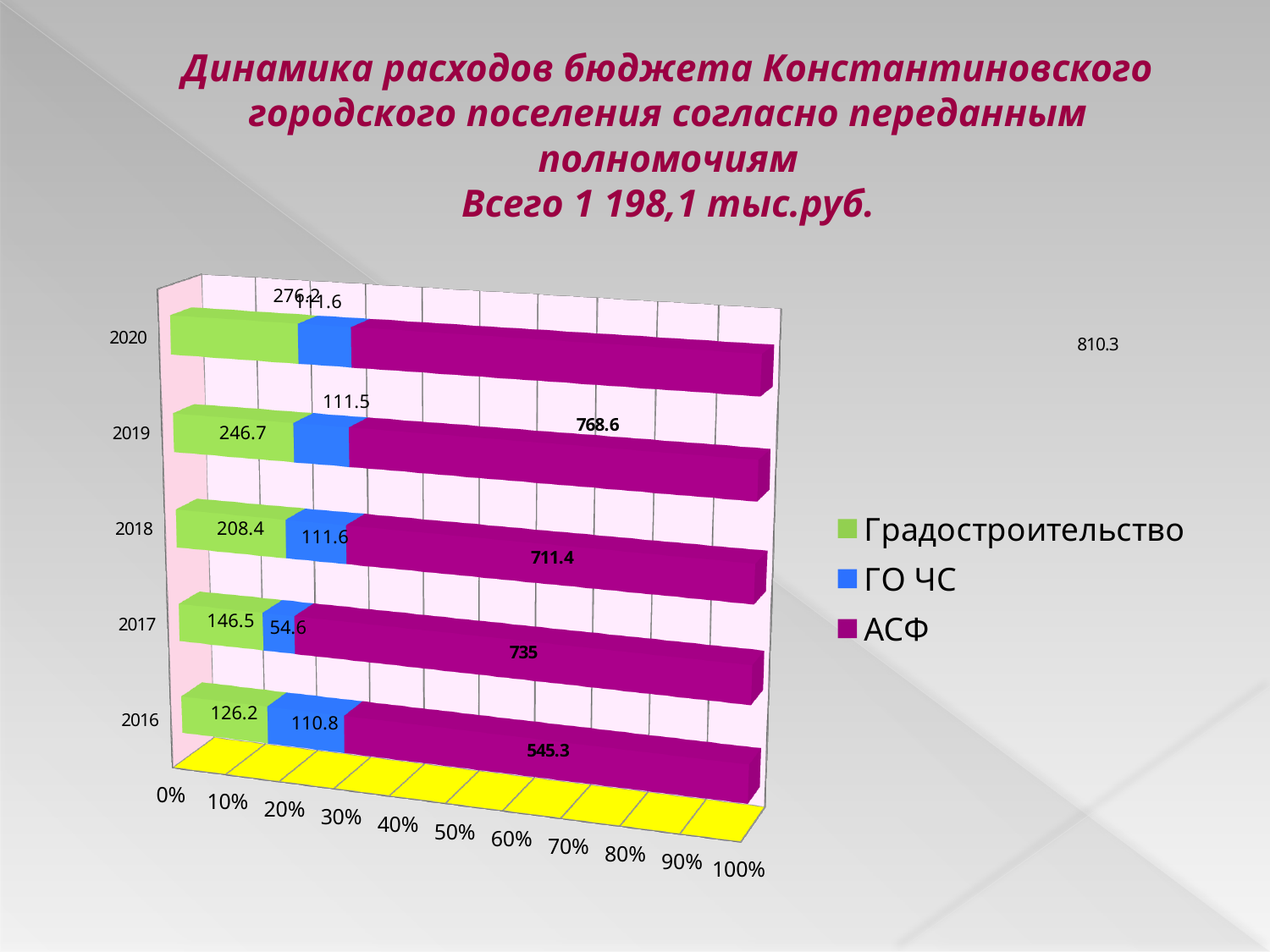
What is the value of АСФ for 2020? 810.3 What kind of chart is shown on the slide? Stacked bar chart How many years are shown on the chart? 5 In which year is the value of ГО ЧС the lowest? 2017 What is the value of Градостроительство for 2019? 246.7 What is the difference between the АСФ values for 2019 and 2018? 57.2 How many series does the legend list? 3 In which year is the value of АСФ the highest? 2020 Which year has the larger Градостроительство value, 2017 or 2018? 2018 Does the value of Градостроительство rise or fall from 2016 to 2020? Rise What is the value of АСФ for 2016? 545.3 What is the value of ГО ЧС for 2017? 54.6